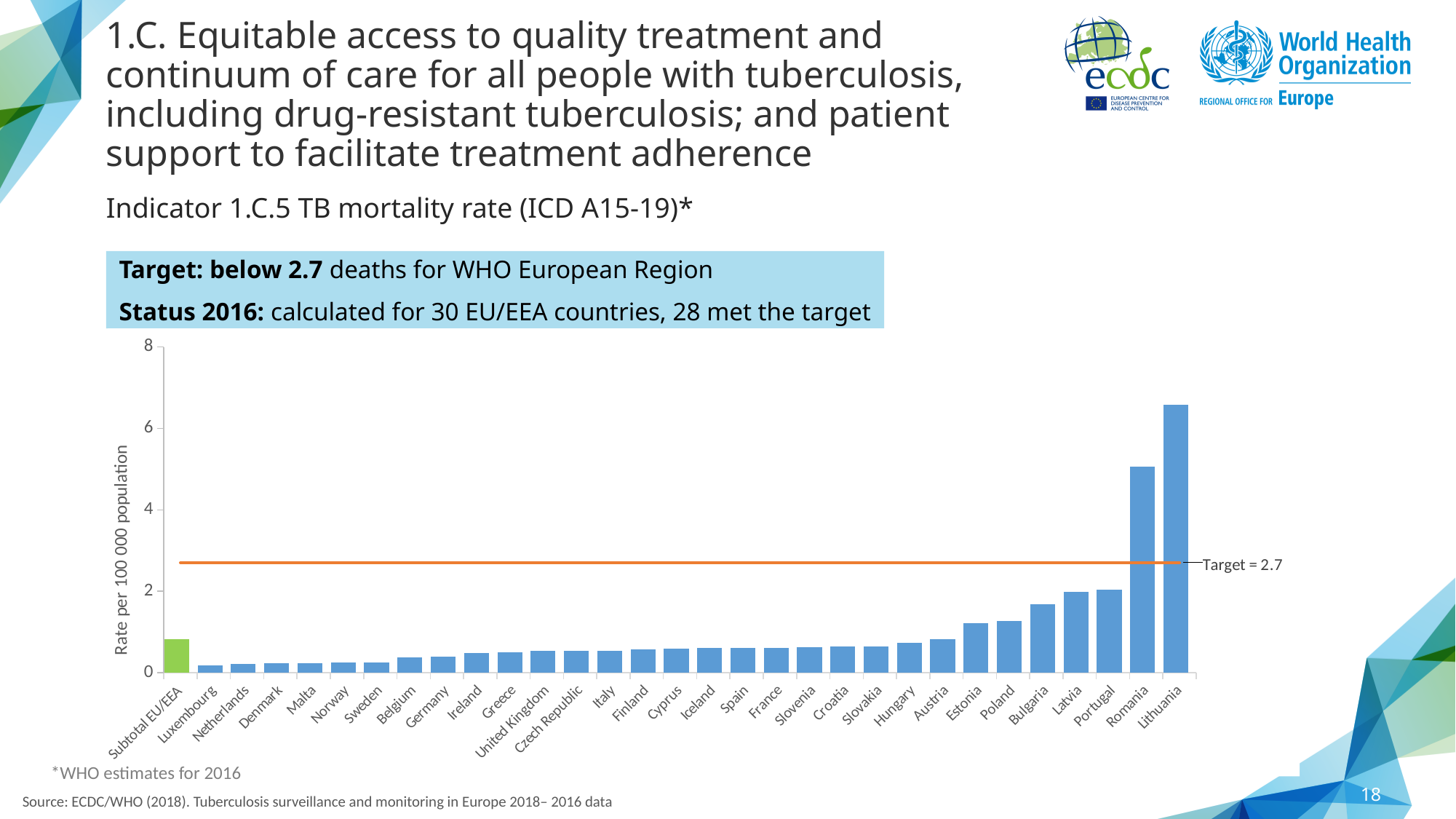
What is the label of the y axis? Rate per 100 000 population Which country has the highest TB mortality rate in the chart? Lithuania Is the value for Portugal greater or less than 4? less What kind of chart is shown on the slide? Bar chart Which has a higher TB mortality rate, Bulgaria or Latvia? Latvia What value does the orange horizontal target line represent? Target = 2.7 How many bars are plotted in the chart, including the Subtotal EU/EEA bar? 31 Is the value for Bulgaria greater or less than 2? less Do the bar values rise or fall from left to right along the x axis? Rise Is the value for Lithuania greater or less than 6? greater Which has a higher TB mortality rate, Romania or Lithuania? Lithuania